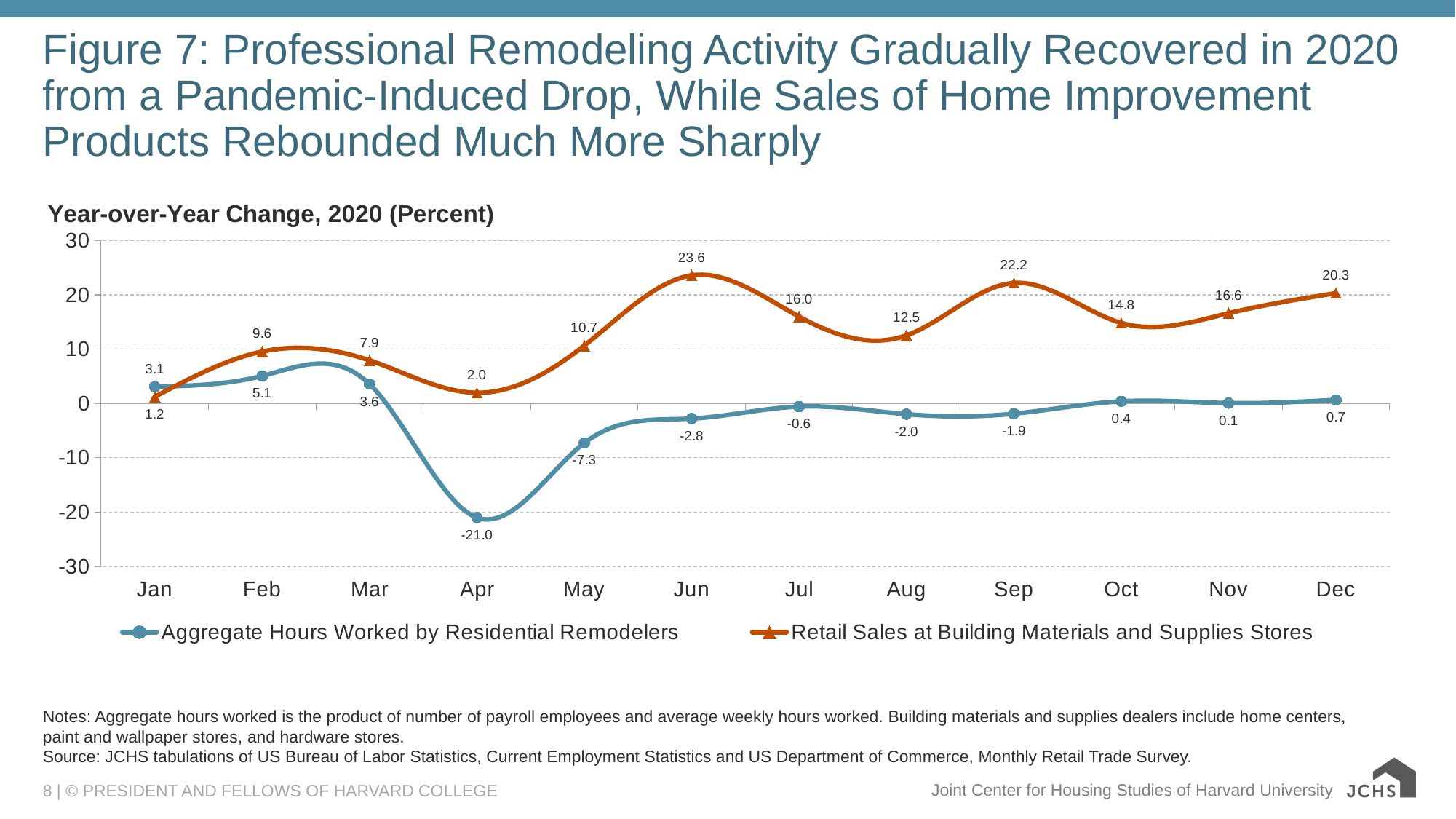
Which series has the larger value in February, Aggregate Hours Worked by Residential Remodelers or Retail Sales at Building Materials and Supplies Stores? Retail Sales at Building Materials and Supplies Stores How many series does the legend list? 2 What is the value for Retail Sales at Building Materials and Supplies Stores in January? 1.2 In which month is Retail Sales at Building Materials and Supplies Stores highest? Jun In which month is Aggregate Hours Worked by Residential Remodelers lowest? Apr Does Retail Sales at Building Materials and Supplies Stores rise or fall from September to October? Fall How many months are plotted on the x axis? 12 What is the value for Aggregate Hours Worked by Residential Remodelers in April? -21.0 What kind of chart is shown on the slide? Line chart What is the axis title shown above the chart? Year-over-Year Change, 2020 (Percent) What is the value for Retail Sales at Building Materials and Supplies Stores in June? 23.6 What is the difference between Retail Sales at Building Materials and Supplies Stores and Aggregate Hours Worked by Residential Remodelers in April? 23.0